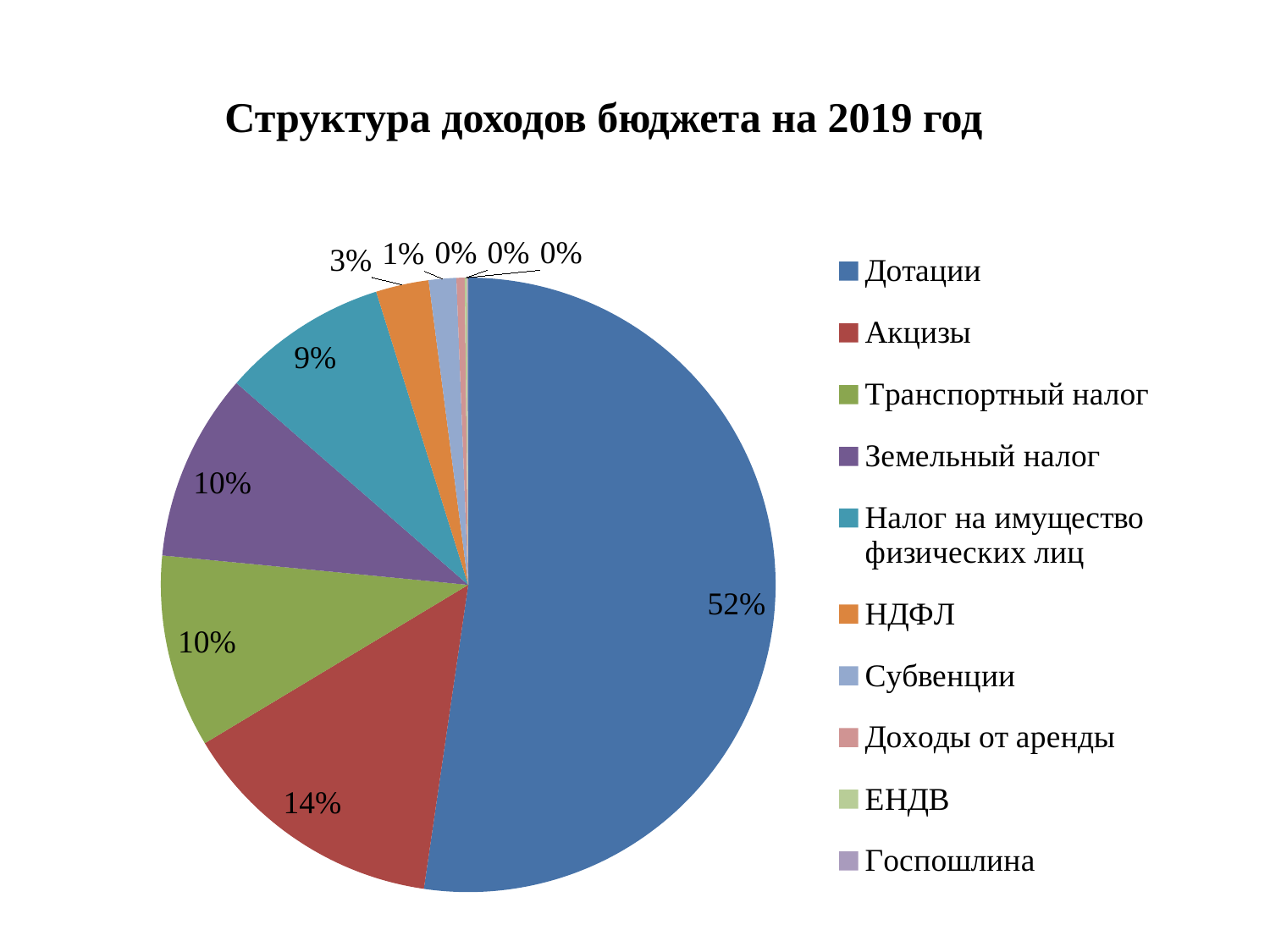
Which category has the largest slice of the pie? Дотации What is the title of the chart? Структура доходов бюджета на 2019 год What share of the pie does Налог на имущество физических лиц take? 9% What kind of chart is shown on the slide? Pie chart What is the combined share of Транспортный налог and Земельный налог? 20% What share of the pie does Акцизы take? 14% What share of the pie does НДФЛ take? 3% What is the difference between the shares of Дотации and Акцизы? 38% How many categories does the legend list? 10 Which is larger, the share of Акцизы or the share of Земельный налог? Акцизы